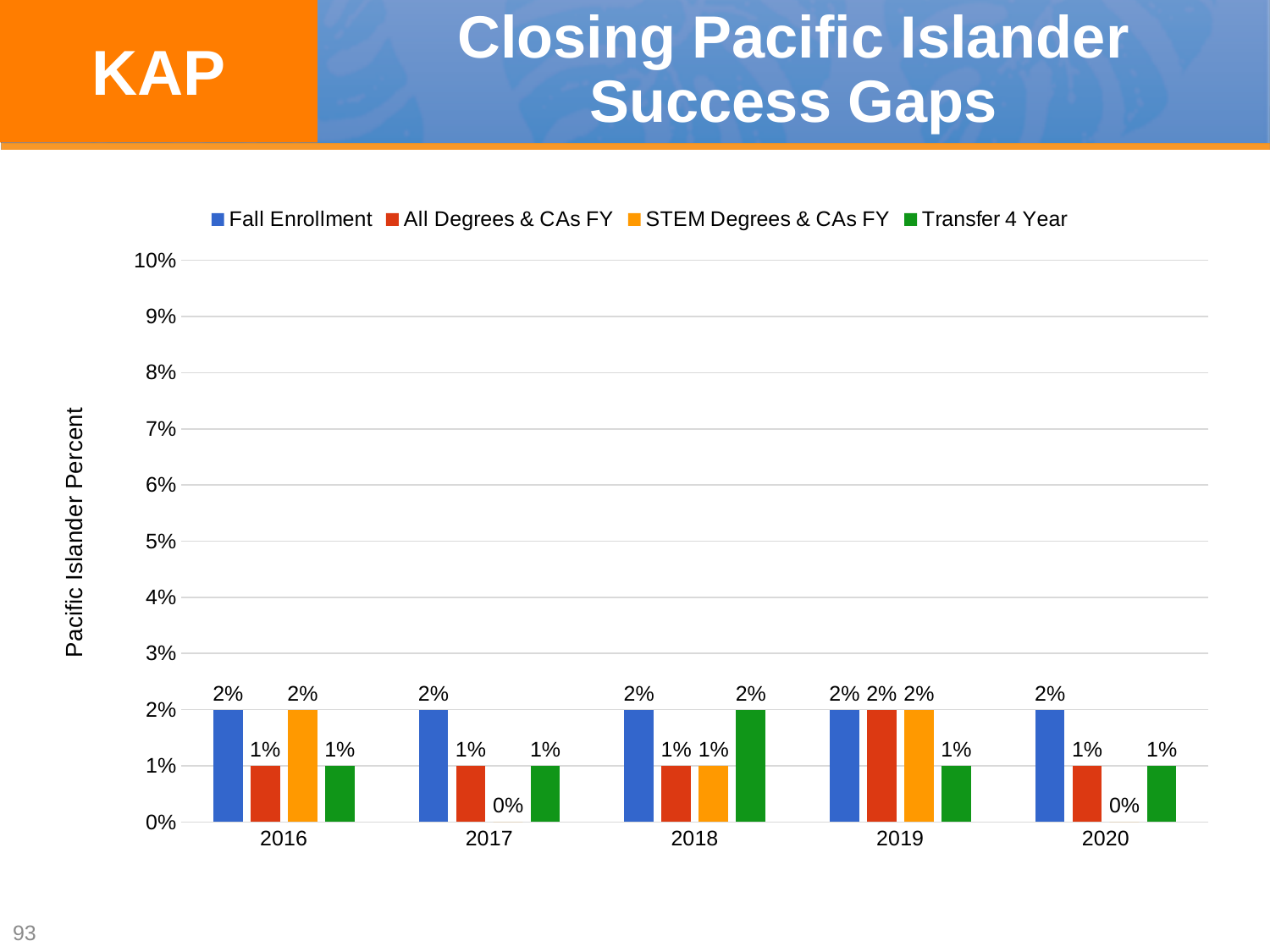
What kind of chart is shown on the slide? bar chart Is the value for Fall Enrollment in 2018 greater or less than 5%? less What is the value for Transfer 4 Year in 2018? 2% What is the difference between Fall Enrollment and All Degrees & CAs FY in 2016? 1% What is the value for STEM Degrees & CAs FY in 2017? 0% How many series does the legend list? 4 Which is larger, Transfer 4 Year in 2018 or Transfer 4 Year in 2019? Transfer 4 Year in 2018 Which series has the lowest value in 2017? STEM Degrees & CAs FY How many years are shown on the x axis? 5 Which series has the lowest value in 2020? STEM Degrees & CAs FY What is the value for All Degrees & CAs FY in 2019? 2% What is the value for Fall Enrollment in 2020? 2%